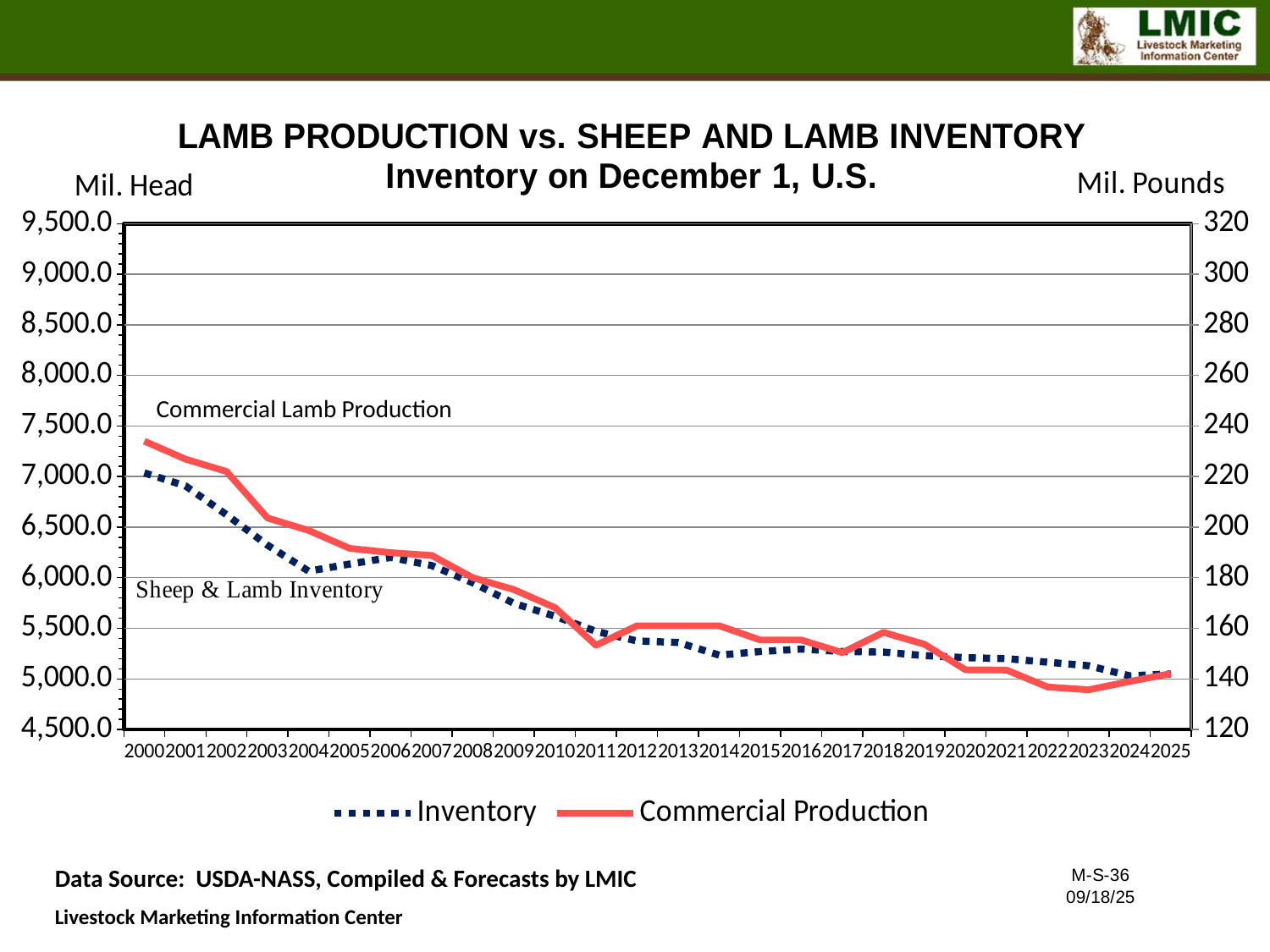
How many years are plotted along the x axis? 26 Is the Inventory value for 2014 greater or less than 5,500.0 Mil. Head? less Does the Commercial Production series generally rise or fall from 2000 to 2025? Fall Which is larger, the Inventory value for 2000 or the Inventory value for 2010? 2000 Does the Inventory series generally rise or fall from 2000 to 2025? Fall Is the Commercial Production value for 2000 greater or less than 220 Mil. Pounds? greater What is the title of the chart? LAMB PRODUCTION vs. SHEEP AND LAMB INVENTORY, Inventory on December 1, U.S. What kind of chart is shown on the slide? Line chart In which year is the Commercial Production series at its highest? 2000 Which series is drawn as a dotted line? Inventory How many series does the legend list? 2 In which year is the Inventory series at its highest? 2000